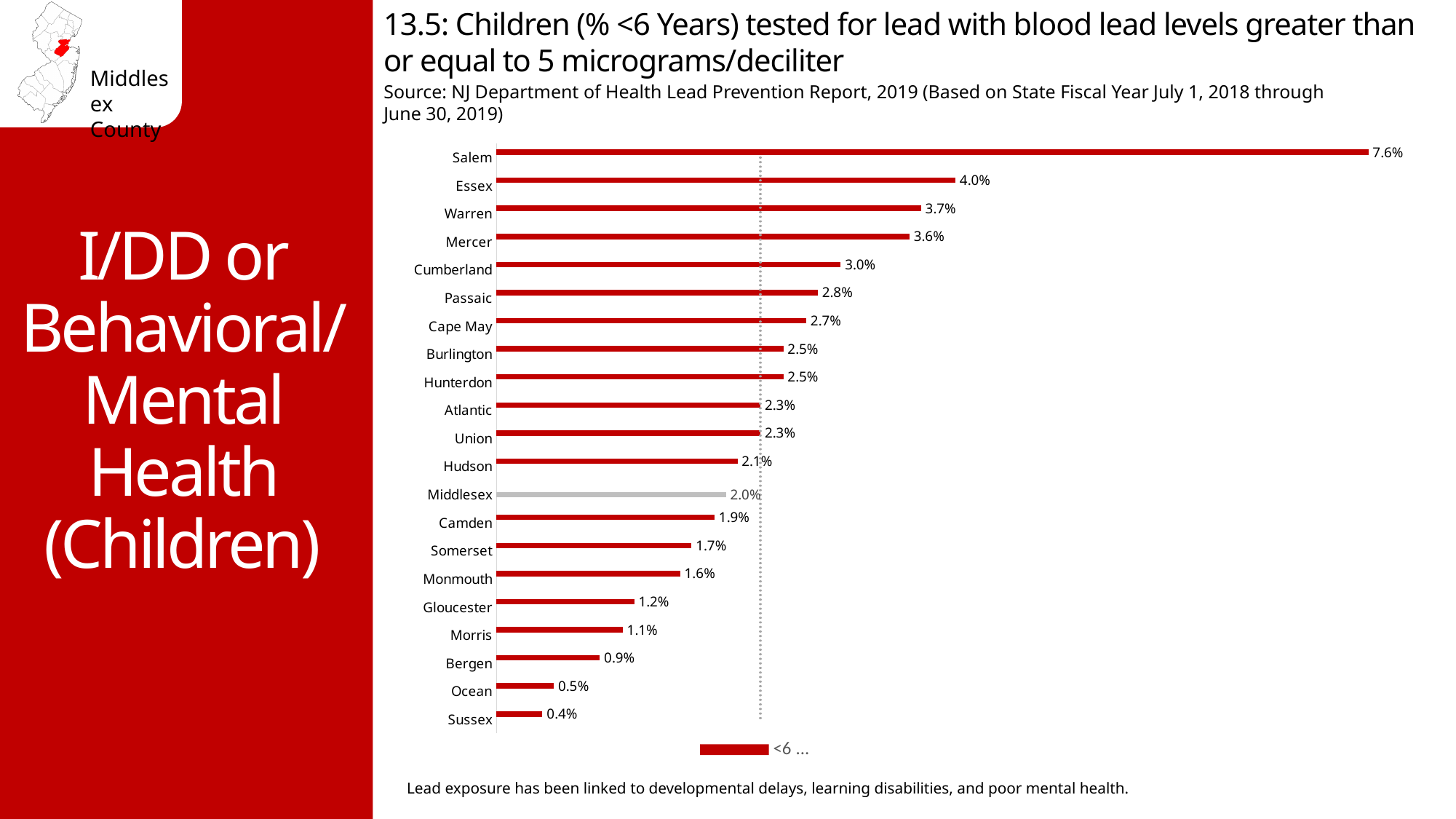
Which county has the highest value? Salem Which county has the lowest value? Sussex What kind of chart is shown on the slide? Bar chart What is the difference between the values for Middlesex and Sussex? 1.6% Which county's bar is shown in grey rather than red? Middlesex How many counties are shown in the chart? 21 What is the value for Salem? 7.6% Which has a larger value, Warren or Mercer? Warren What is the value for Bergen? 0.9% What is the value for Cumberland? 3.0% What is the difference between the values for Salem and Essex? 3.6% What is the value for Middlesex? 2.0%